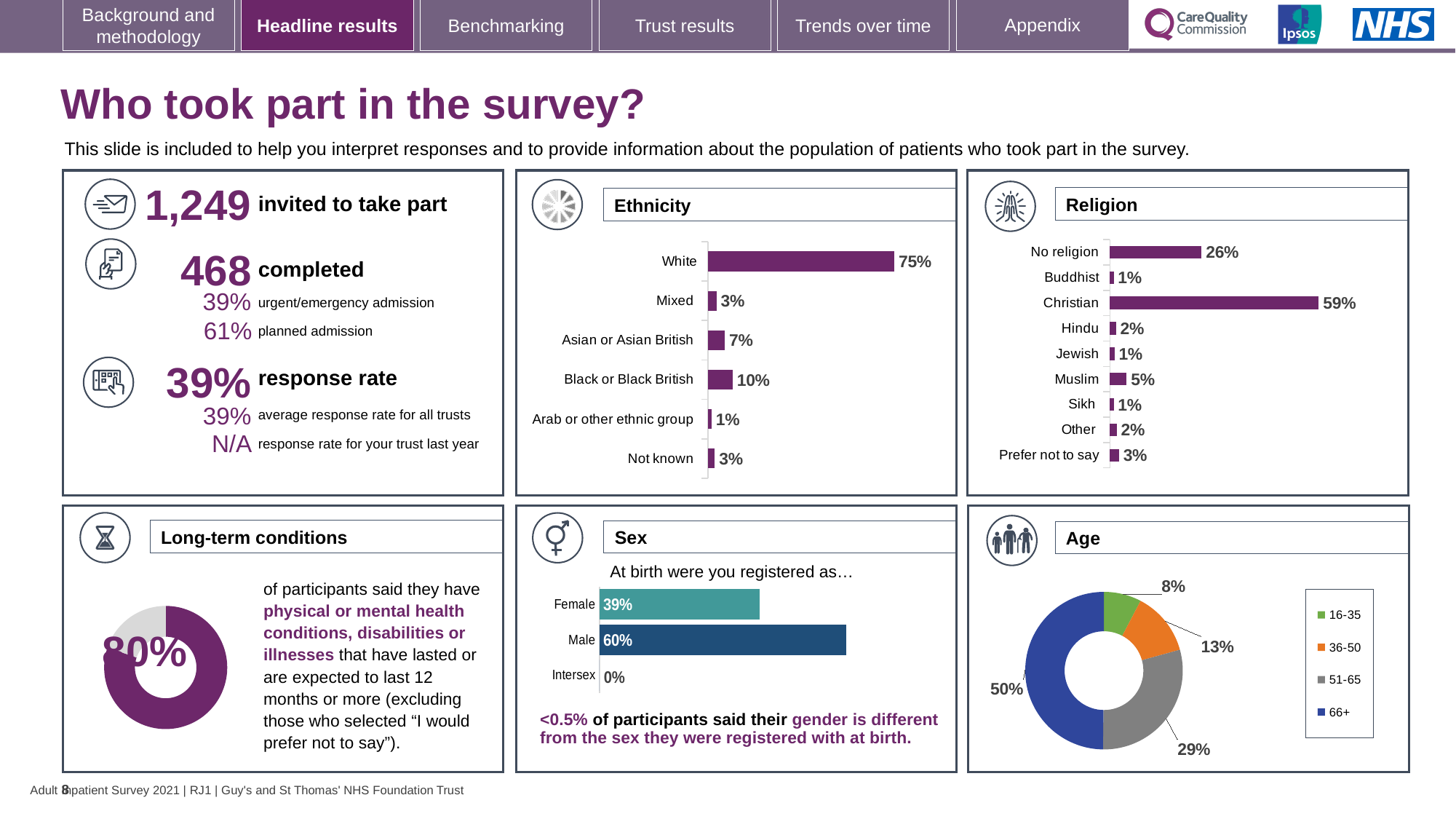
In the Religion chart, what percentage of participants were Christian? 59% In the Ethnicity chart, what is the difference between the percentages for Black or Black British and Asian or Asian British? 3% In the Ethnicity chart, which ethnic group has the lowest percentage? Arab or other ethnic group In the Ethnicity chart, what percentage of participants were White? 75% In the Religion chart, which is larger, the percentage for Muslim or the percentage for Hindu? Muslim In the Religion chart, how many categories are shown? 9 What type of chart is used for the Age breakdown? Donut chart In the Age chart, what share of participants were aged 66+? 50% In the Age chart, how many age groups does the legend list? 4 In the Sex chart, what percentage of participants were registered as Male at birth? 60% In the Religion chart, which religion category has the highest percentage? Christian In the Ethnicity chart, how many ethnicity categories are shown? 6